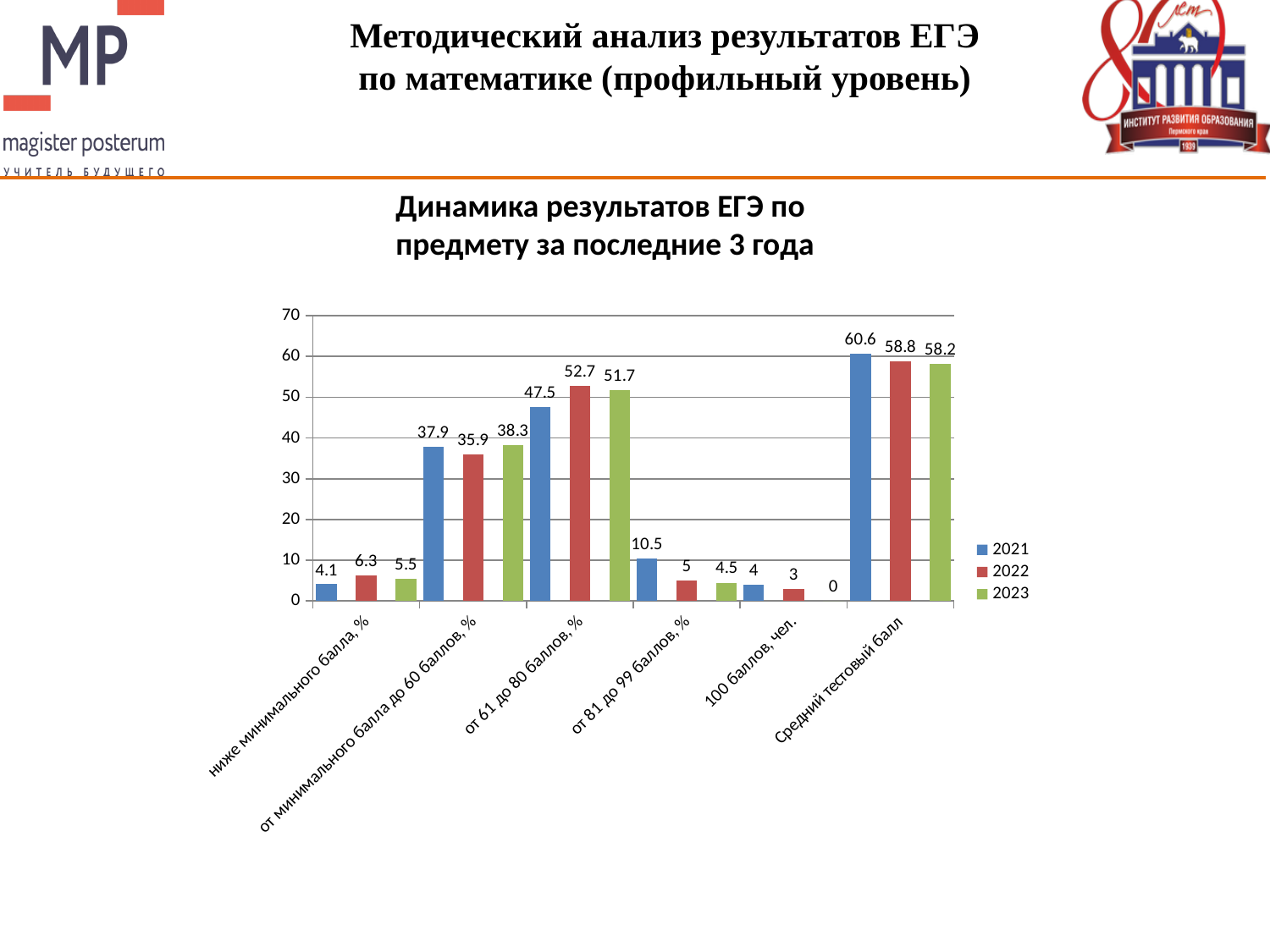
How many categories are shown on the x axis? 6 What is the value for 2022 in the category "ниже минимального балла, %"? 6.3 What is the value for 2023 in the category "100 баллов, чел."? 0 How many series does the legend list? 3 What is the value for 2021 in the category "от 61 до 80 баллов, %"? 47.5 Which is larger in the category "от 61 до 80 баллов, %": the value for 2022 or for 2023? 2022 What is the value for 2023 in the category "Средний тестовый балл"? 58.2 What is the title of the chart? Динамика результатов ЕГЭ по предмету за последние 3 года What is the difference between the 2021 and 2022 values in the category "Средний тестовый балл"? 1.8 Which year has the lowest value in the category "от минимального балла до 60 баллов, %"? 2022 Which year has the highest value in the category "от 81 до 99 баллов, %"? 2021 What kind of chart is shown on the slide? bar chart